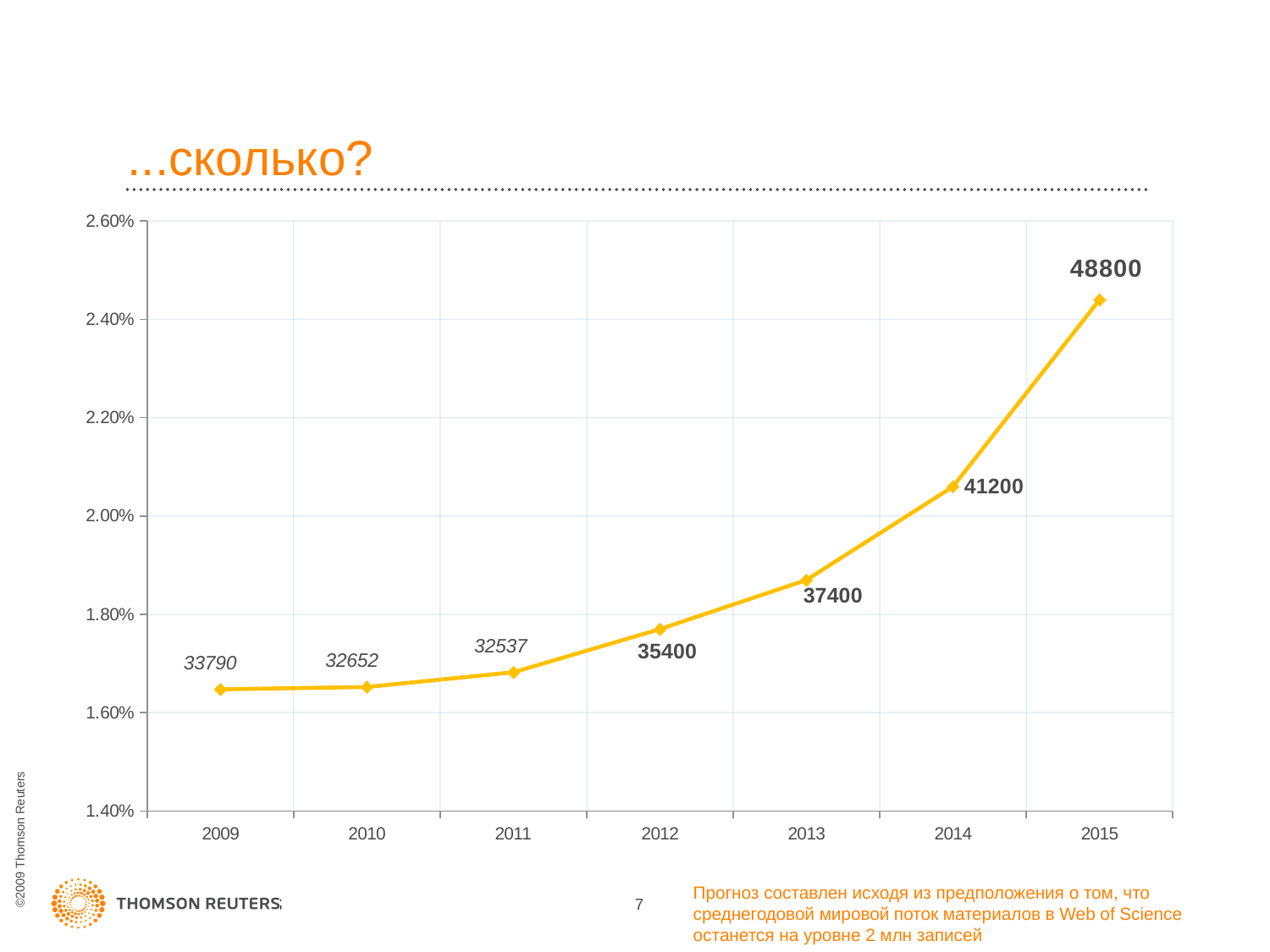
What kind of chart is shown on the slide? line chart What is the difference between the data labels for 2015 and 2014? 7600 What is the data label shown for 2011? 32537 Does the line generally rise or fall from 2011 to 2015? rise Which year has the lowest data label value? 2011 What is the data label shown for 2009? 33790 Which has the larger data label, 2012 or 2010? 2012 What is the data label shown for 2013? 37400 How many data points are plotted on the line? 7 Is the plotted value for 2014 greater or less than 2.00%? greater What is the data label shown for 2015? 48800 Which year has the highest data label value? 2015